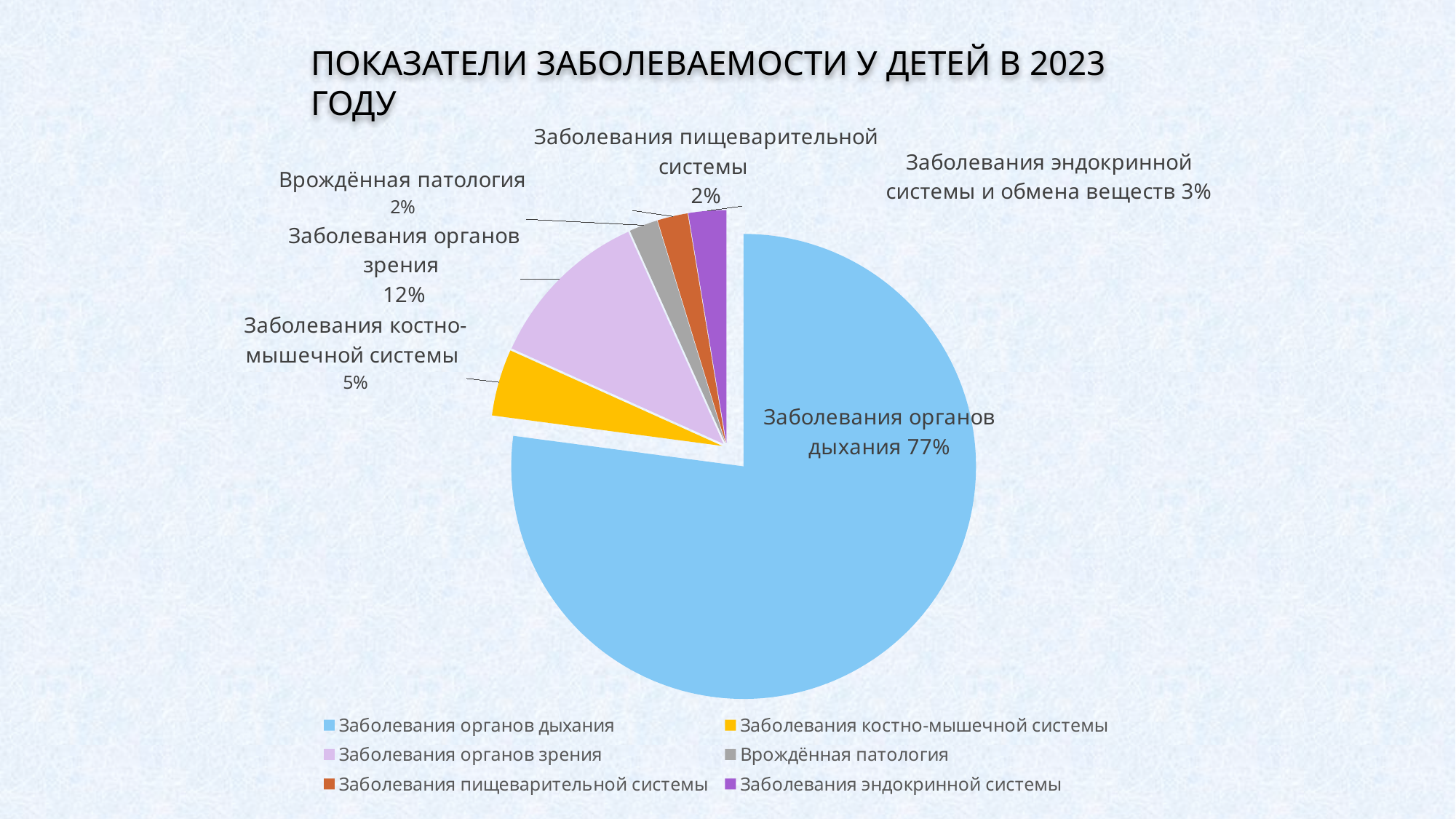
How many entries does the legend list? 6 Which category has the largest slice of the pie? Заболевания органов дыхания What share of the pie does "Заболевания органов зрения" have? 12% What is the title of the chart? ПОКАЗАТЕЛИ ЗАБОЛЕВАЕМОСТИ У ДЕТЕЙ В 2023 ГОДУ What is the value for "Врождённая патология"? 2% How many categories (slices) does the pie chart have? 6 What share of the pie does "Заболевания органов дыхания" have? 77% What is the value for "Заболевания эндокринной системы и обмена веществ"? 3% What is the difference between the shares of "Заболевания органов дыхания" and "Заболевания органов зрения"? 65% What is the value for "Заболевания костно-мышечной системы"? 5% What kind of chart is shown on the slide? pie chart Which is larger: the share for "Заболевания костно-мышечной системы" or for "Заболевания эндокринной системы и обмена веществ"? Заболевания костно-мышечной системы